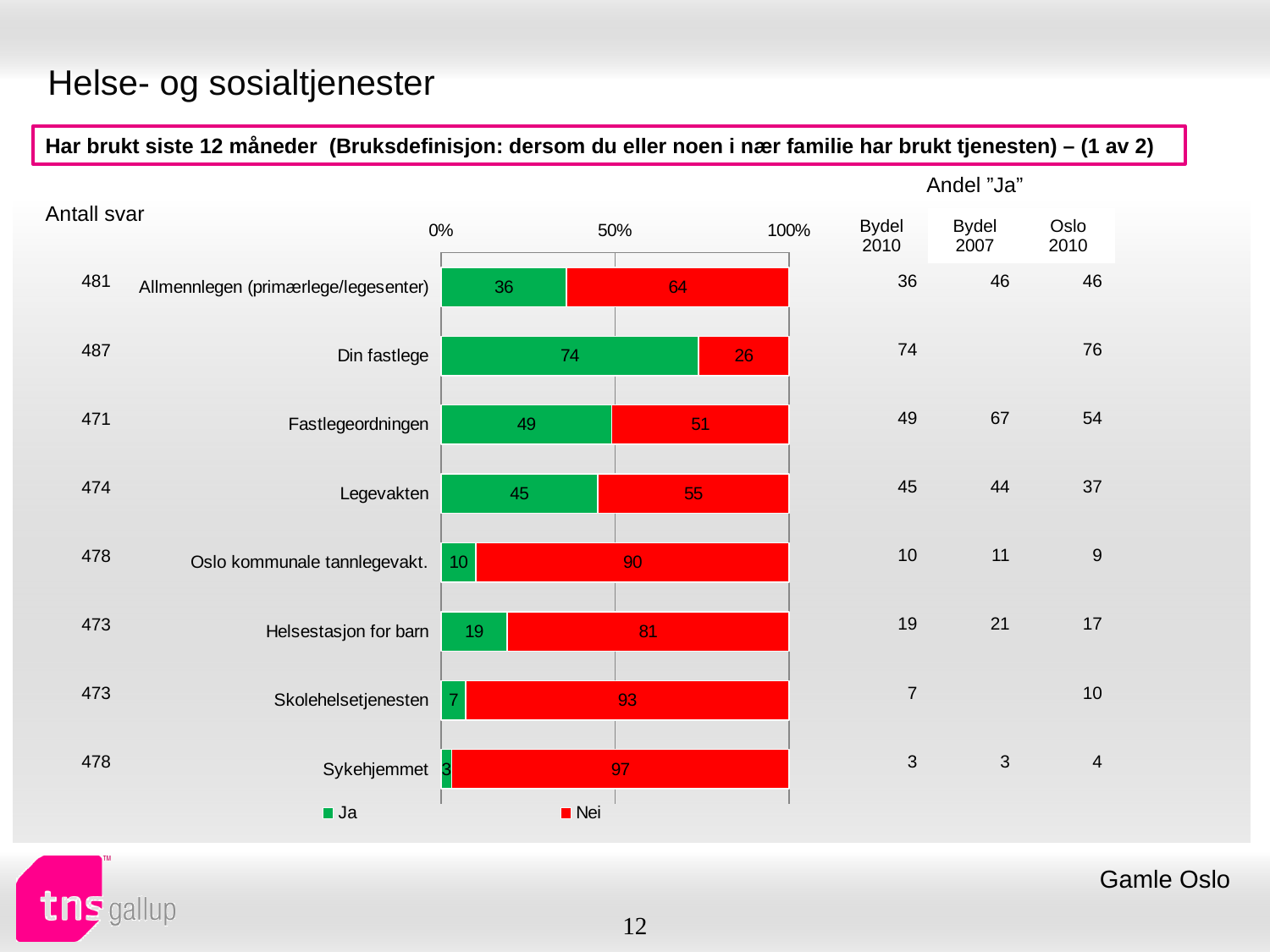
Is the "Nei" value for Din fastlege greater or less than 50%? less What is the total of the stacked bar for Legevakten? 100 Which category has the highest "Ja" value? Din fastlege Which category has the lowest "Ja" value? Sykehjemmet What kind of chart is shown on the slide? Stacked bar chart What is the "Ja" value for Helsestasjon for barn? 19 What is the "Nei" value for Oslo kommunale tannlegevakt.? 90 What is the "Ja" value for Din fastlege? 74 What is the difference between the "Nei" values for Skolehelsetjenesten and Legevakten? 38 Which has a larger "Ja" value, Fastlegeordningen or Allmennlegen (primærlege/legesenter)? Fastlegeordningen How many series does the legend list? 2 How many categories are shown in the chart? 8